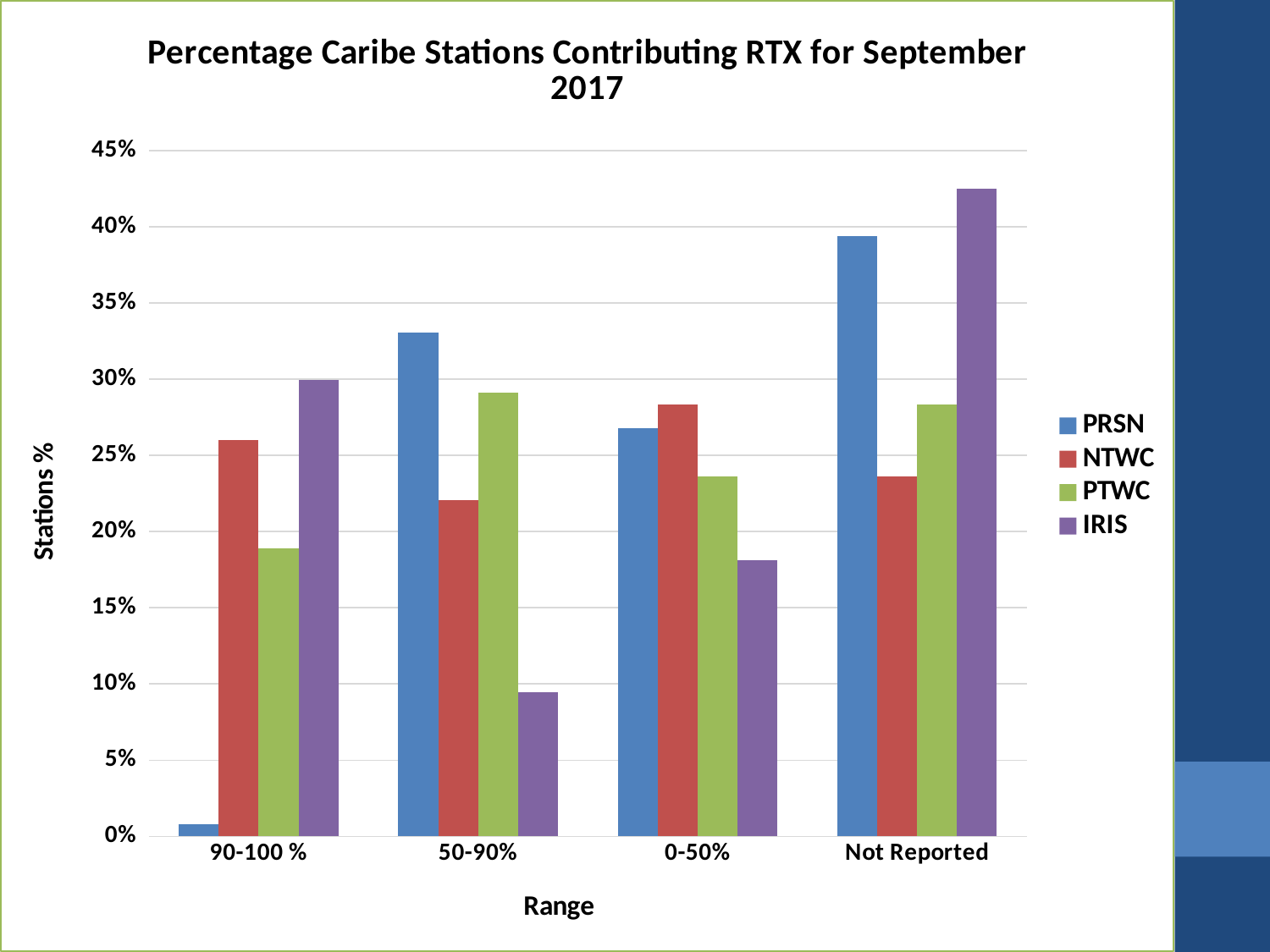
How many range categories are shown on the x axis? 4 How many series does the legend list? 4 Is the PRSN value for 50-90% greater or less than 30%? greater In the 90-100 % category, which is larger, NTWC or PTWC? NTWC Is the IRIS value for 50-90% greater or less than 10%? less Is the IRIS value for Not Reported greater or less than 40%? greater Which range category has the lowest PRSN value? 90-100 % In the Not Reported category, which is larger, IRIS or PRSN? IRIS In the 50-90% category, which series has the highest value? PRSN What kind of chart is shown on the slide? Bar chart Which range category has the highest PRSN value? Not Reported What is the label of the y axis? Stations %